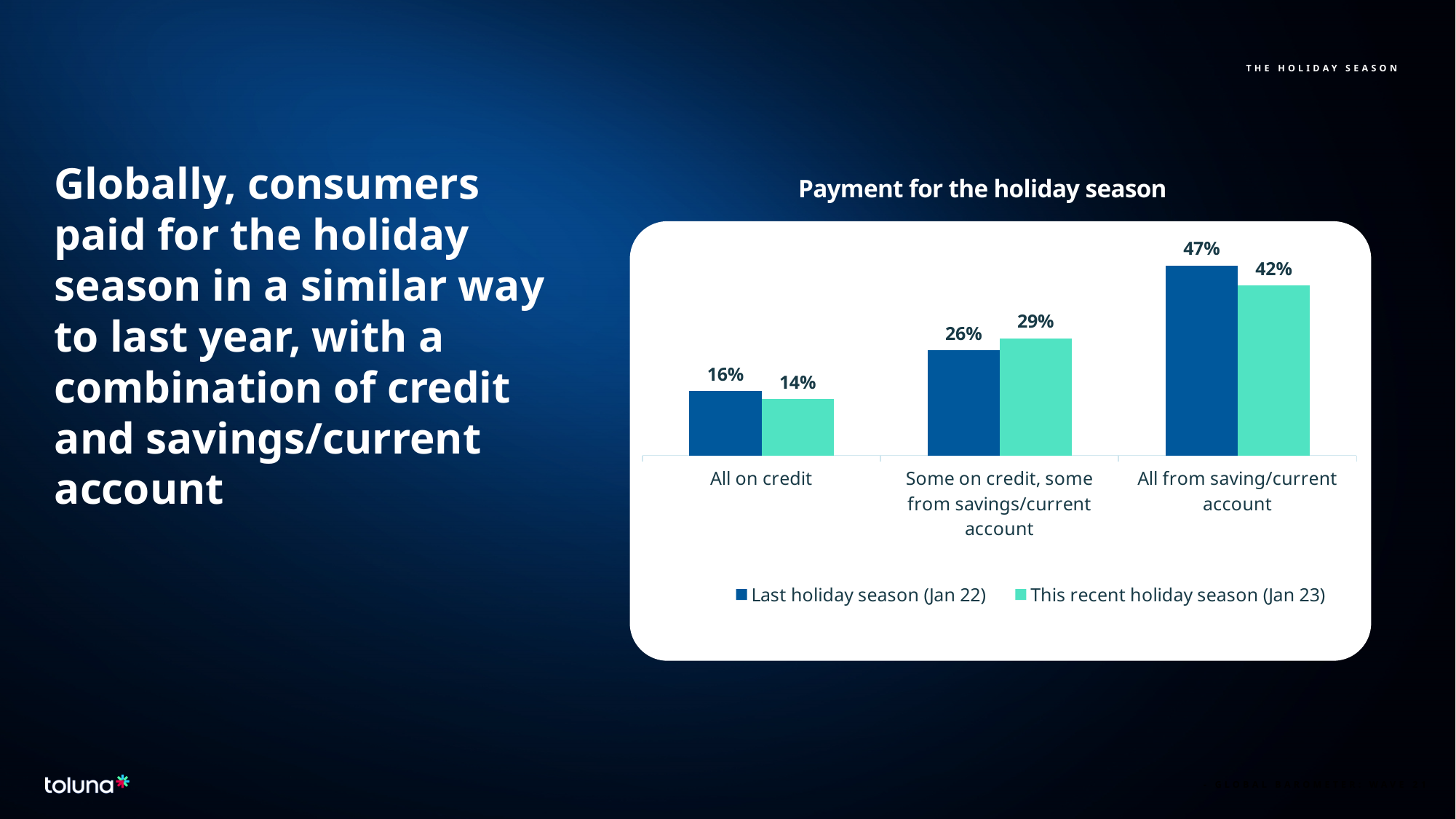
For 'Some on credit, some from savings/current account', which series has the larger value: Last holiday season (Jan 22) or This recent holiday season (Jan 23)? This recent holiday season (Jan 23) Do the values in the Last holiday season (Jan 22) series rise or fall from left to right along the x axis? Rise Which category has the lowest value in the This recent holiday season (Jan 23) series? All on credit What is the value for 'Some on credit, some from savings/current account' in the This recent holiday season (Jan 23) series? 29% Which category has the highest value in the Last holiday season (Jan 22) series? All from saving/current account What kind of chart is shown on the slide? Bar chart What is the difference between the Jan 22 and Jan 23 values for 'All from saving/current account'? 5% What is the value for 'All on credit' in the Last holiday season (Jan 22) series? 16% How many series does the legend list? 2 What is the value for 'All from saving/current account' in the This recent holiday season (Jan 23) series? 42% How many categories are shown on the x axis? 3 What is the title of the chart? Payment for the holiday season